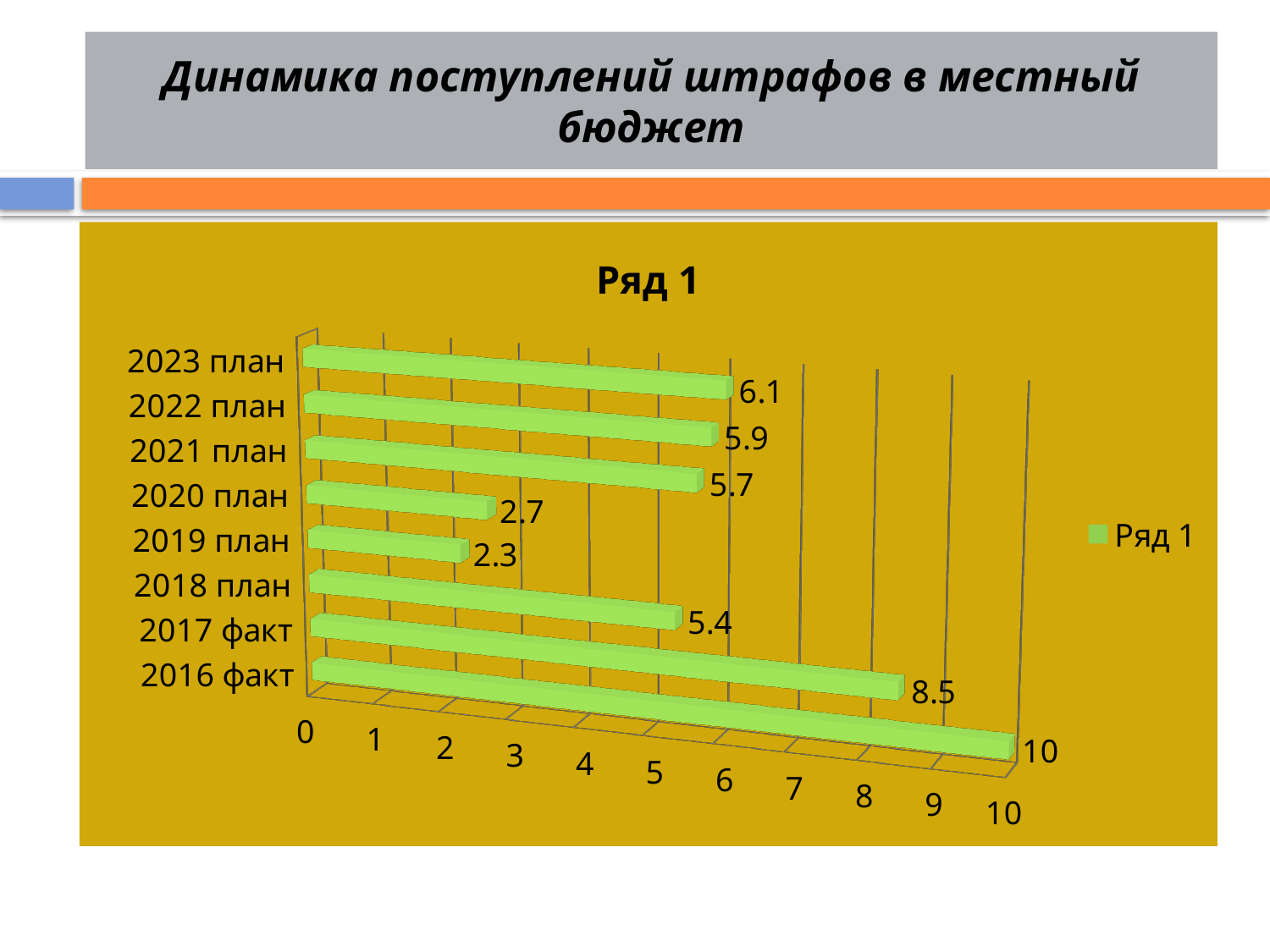
What kind of chart is shown on the slide? bar chart How many series does the legend list? 1 How many categories are shown in the chart? 8 Which category has the lowest value? 2019 план What is the difference between the values for 2016 факт and 2017 факт? 1.5 Which is larger, the value for 2020 план or the value for 2021 план? 2021 план What is the value for 2018 план? 5.4 What is the name of the series shown in the legend? Ряд 1 Which category has the highest value? 2016 факт What is the value for 2023 план? 6.1 What is the value for 2016 факт? 10 What is the value for 2019 план? 2.3